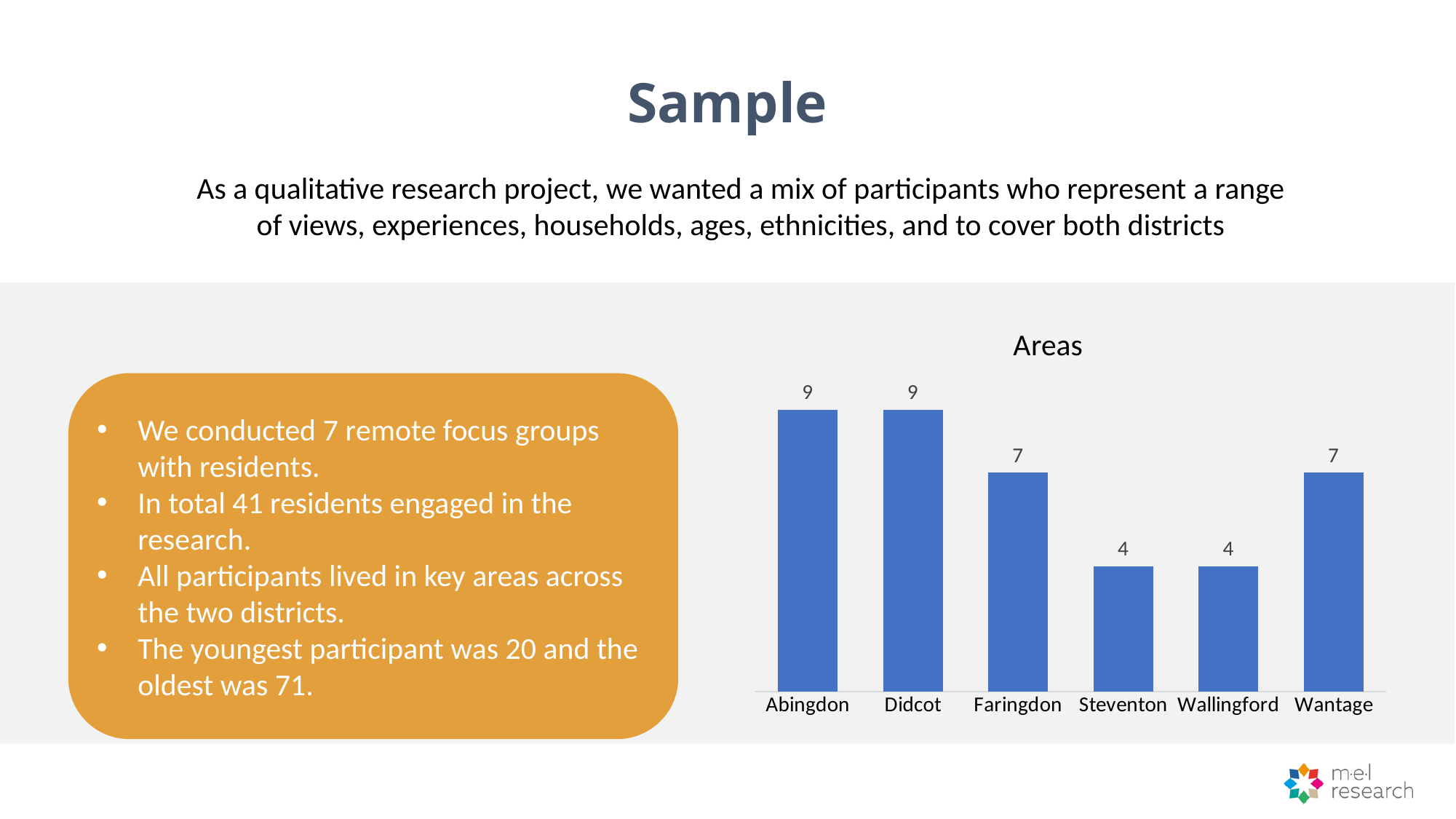
What is the value for Wantage in the Areas chart? 7 What is the title of the chart on the slide? Areas What is the value for Abingdon in the Areas chart? 9 Which is larger in the Areas chart, the value for Wantage or the value for Steventon? Wantage Which areas have the lowest value in the Areas chart? Steventon and Wallingford How many areas are shown in the Areas chart? 6 What is the difference between the values for Abingdon and Faringdon in the Areas chart? 2 What is the value for Faringdon in the Areas chart? 7 What kind of chart is the Areas chart? Bar chart What is the value for Steventon in the Areas chart? 4 Which areas have the highest value in the Areas chart? Abingdon and Didcot What is the difference between the values for Didcot and Wallingford in the Areas chart? 5